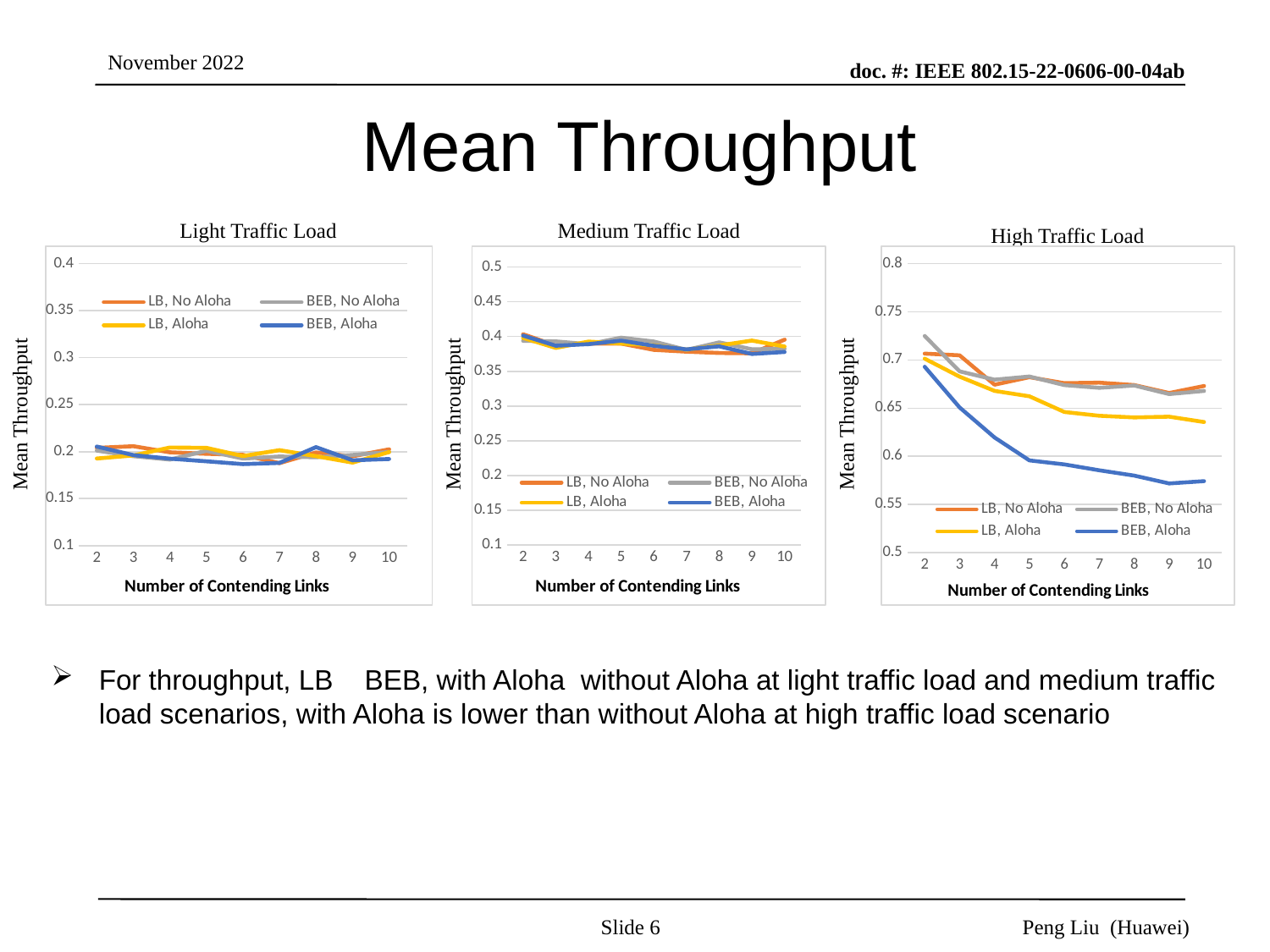
What kind of chart is the Light Traffic Load chart? line chart What is the title of the rightmost chart on the slide? High Traffic Load In the High Traffic Load chart, is the value for BEB, No Aloha at 2 contending links greater or less than 0.7? greater In the High Traffic Load chart, does the BEB, Aloha series rise or fall as the number of contending links increases? fall How many series does the legend of the Medium Traffic Load chart list? 4 In the High Traffic Load chart, at 10 contending links, which is larger: LB, Aloha or BEB, Aloha? LB, Aloha In the High Traffic Load chart, which series has the lowest value at 10 contending links? BEB, Aloha What is the x-axis label of the Medium Traffic Load chart? Number of Contending Links In the High Traffic Load chart, is the value for BEB, Aloha at 9 contending links greater or less than 0.6? less In the Medium Traffic Load chart, is the value for LB, No Aloha at 2 contending links greater or less than 0.35? greater How many x-axis points (numbers of contending links) are plotted in the High Traffic Load chart? 9